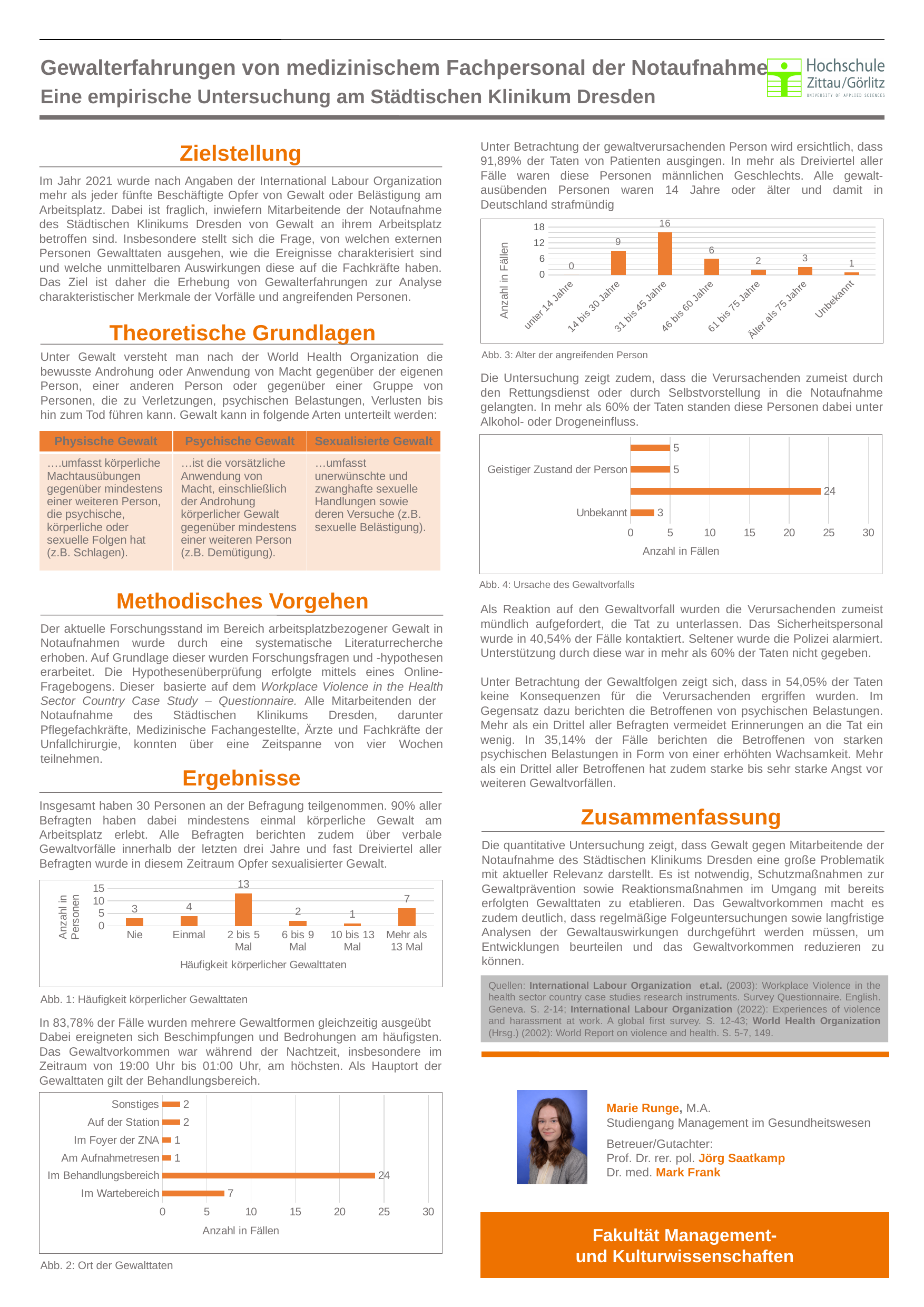
In the chart 'Abb. 3: Alter der angreifenden Person', which is larger, the value for '46 bis 60 Jahre' or the value for 'Älter als 75 Jahre'? 46 bis 60 Jahre In the chart 'Abb. 1: Häufigkeit körperlicher Gewalttaten', how many categories are shown on the x axis? 6 In the chart 'Abb. 2: Ort der Gewalttaten', which category has the highest value? Im Behandlungsbereich In the chart 'Abb. 2: Ort der Gewalttaten', what is the value for 'Im Wartebereich'? 7 In the chart 'Abb. 3: Alter der angreifenden Person', how many age categories are shown on the x axis? 7 In the chart 'Abb. 4: Ursache des Gewaltvorfalls', what is the value for 'Unbekannt'? 3 In the chart 'Abb. 1: Häufigkeit körperlicher Gewalttaten', which category has the lowest value? 10 bis 13 Mal In the chart 'Abb. 3: Alter der angreifenden Person', what is the value for '14 bis 30 Jahre'? 9 What kind of chart is 'Abb. 2: Ort der Gewalttaten'? Bar chart In the chart 'Abb. 1: Häufigkeit körperlicher Gewalttaten', what is the difference between the values for 'Mehr als 13 Mal' and 'Einmal'? 3 In the chart 'Abb. 3: Alter der angreifenden Person', which category has the highest value? 31 bis 45 Jahre In the chart 'Abb. 1: Häufigkeit körperlicher Gewalttaten', what is the value for '2 bis 5 Mal'? 13